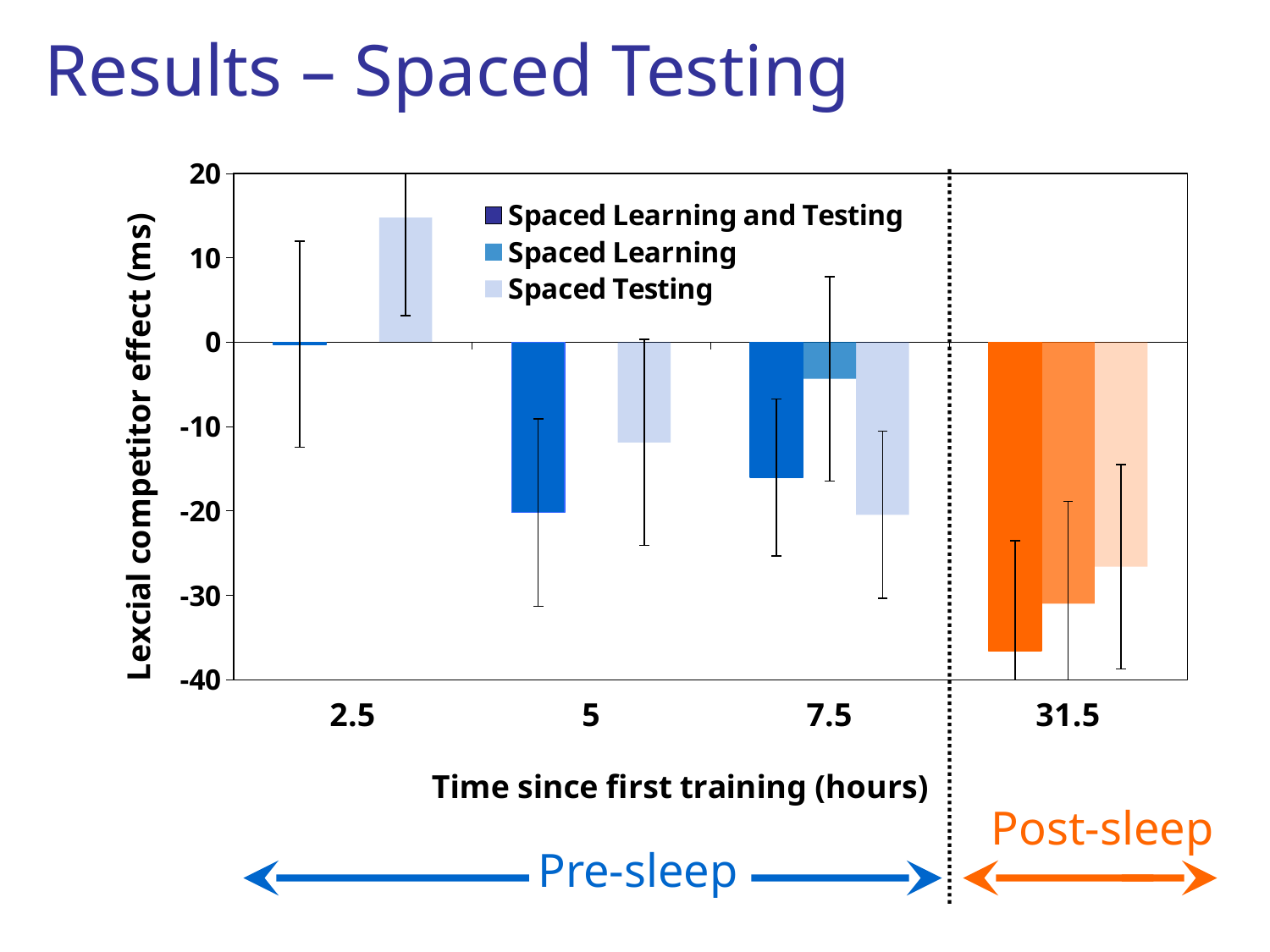
Is the Spaced Testing value at 2.5 hours greater or less than 10? greater Is the Spaced Learning value at 7.5 hours greater or less than -10? greater Is the Spaced Learning and Testing value at 5 hours greater or less than -10? less At which time point is the Spaced Learning and Testing value lowest? 31.5 How many time points are shown on the x axis? 4 What kind of chart is shown on the slide? bar chart How many series does the legend list? 3 What is the title of the x axis? Time since first training (hours) At 31.5 hours, which series has the lower value: Spaced Learning and Testing or Spaced Testing? Spaced Learning and Testing Which time point on the x axis falls in the Post-sleep section? 31.5